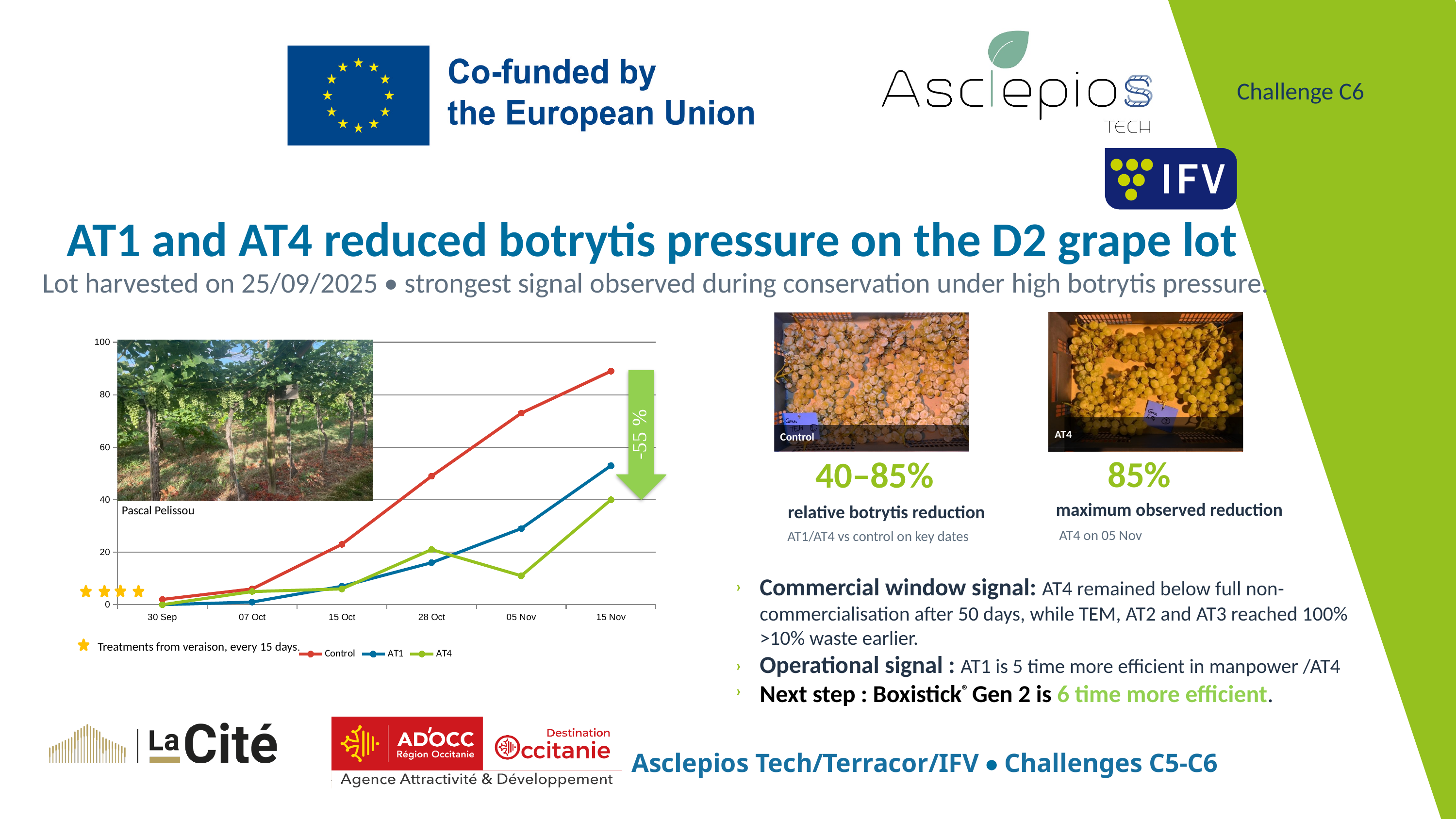
Is the value for Control on 05 Nov greater or less than 60? greater How many series does the chart legend list? 3 How many dates are shown along the x axis of the chart? 6 Which series has the highest value on 15 Nov? Control Is the value for AT4 on 05 Nov greater or less than 20? less Is the value for Control on 15 Nov greater or less than 80? greater Does the Control series rise or fall from 30 Sep to 15 Nov? rise Which series has the lowest value on 15 Nov? AT4 What percentage is written on the green arrow next to the chart? -55 % On 05 Nov, which is larger: the value for Control or the value for AT1? Control What kind of chart is shown on the left of the slide? line chart